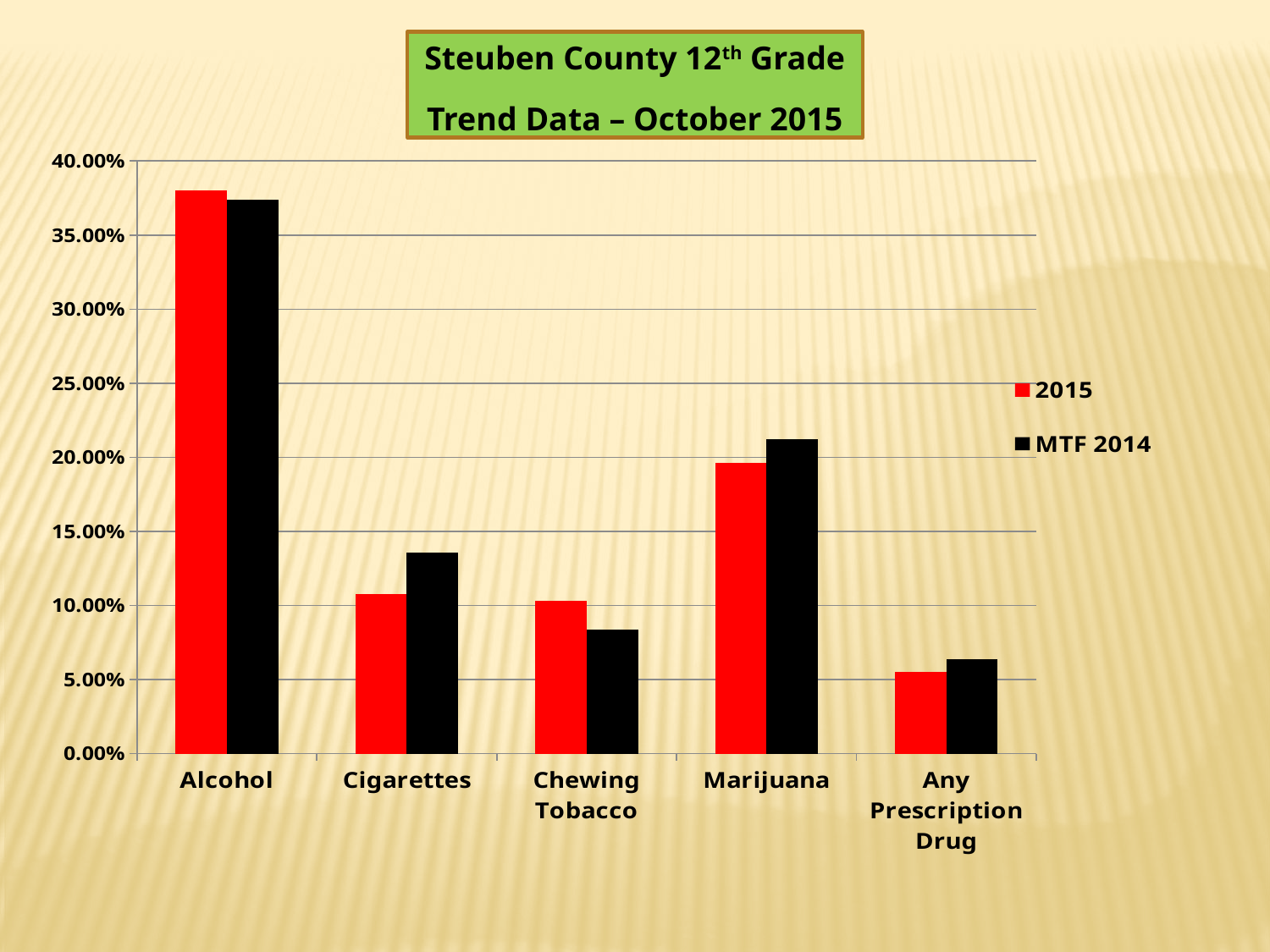
Is the MTF 2014 value for Chewing Tobacco greater or less than 10.00%? less What kind of chart is shown on the slide? bar chart Which category has the highest value for the 2015 series? Alcohol For Cigarettes, which series has the larger value, 2015 or MTF 2014? MTF 2014 Is the 2015 value for Alcohol greater or less than 35.00%? greater How many series does the chart's legend list? 2 Which colour represents the MTF 2014 series in the chart? black Is the MTF 2014 value for Cigarettes greater or less than 15.00%? less How many categories are shown on the x axis of the chart? 5 Which category has the lowest value for the MTF 2014 series? Any Prescription Drug For Chewing Tobacco, which series has the larger value, 2015 or MTF 2014? 2015